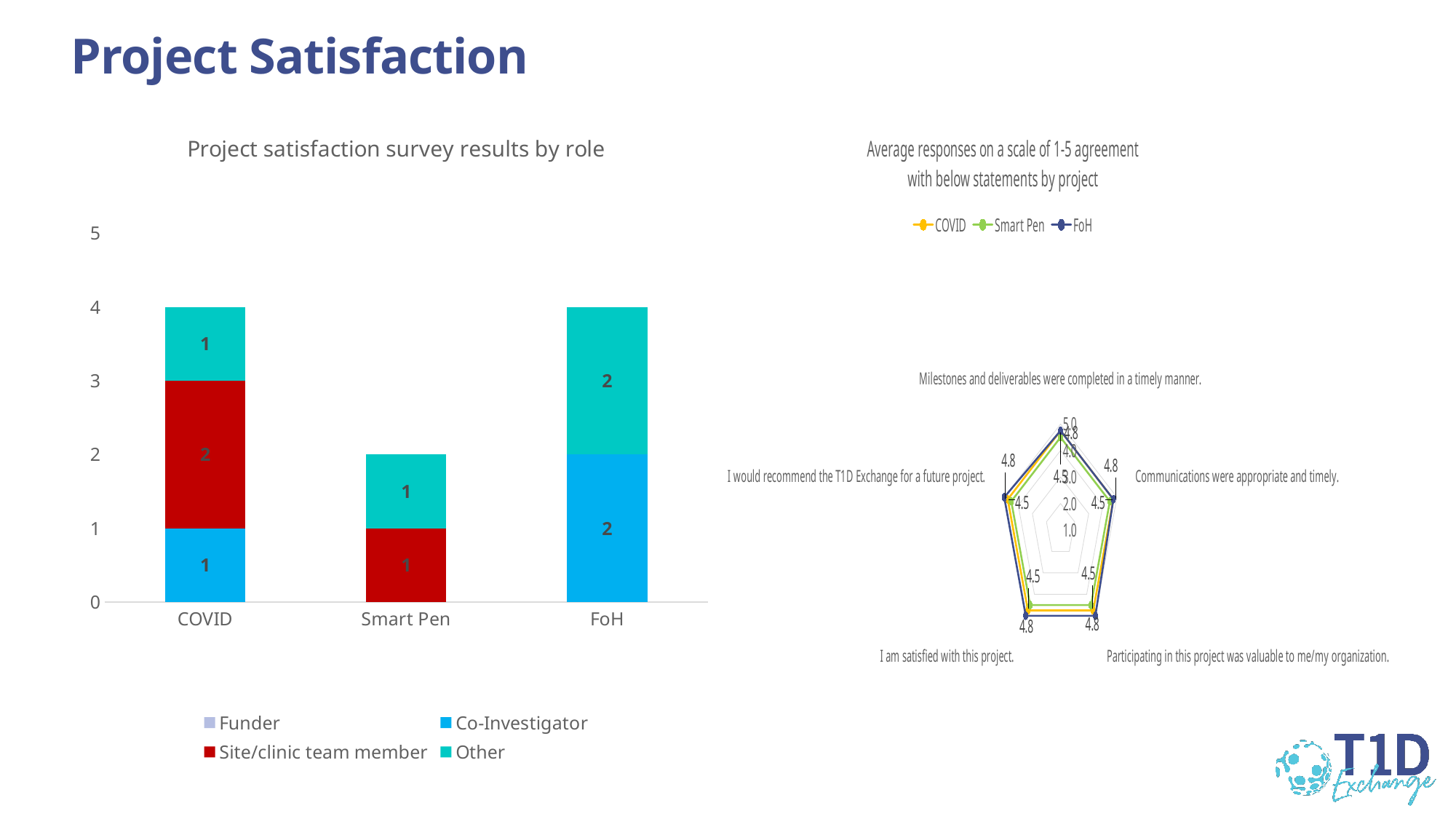
What kind of chart is the 'Average responses on a scale of 1-5 agreement' chart on the right? Radar chart In the 'Project satisfaction survey results by role' chart, which is larger: the Co-Investigator value for COVID or the Co-Investigator value for FoH? FoH In the 'Project satisfaction survey results by role' chart, what is the total of the stacked bar for Smart Pen? 2 In the 'Average responses on a scale of 1-5 agreement' chart on the right, how many series does the legend list? 3 In the 'Project satisfaction survey results by role' chart, what is the value for Other for Smart Pen? 1 In the 'Project satisfaction survey results by role' chart, what is the value for Site/clinic team member for COVID? 2 What kind of chart is the 'Project satisfaction survey results by role' chart? Stacked bar chart In the 'Project satisfaction survey results by role' chart, what is the value for Co-Investigator for FoH? 2 In the 'Project satisfaction survey results by role' chart, which project has the lowest total bar? Smart Pen In the 'Project satisfaction survey results by role' chart, how many series does the legend list? 4 In the 'Project satisfaction survey results by role' chart, what is the total of the stacked bar for COVID? 4 In the 'Project satisfaction survey results by role' chart, what is the difference between the Other value for FoH and the Other value for COVID? 1